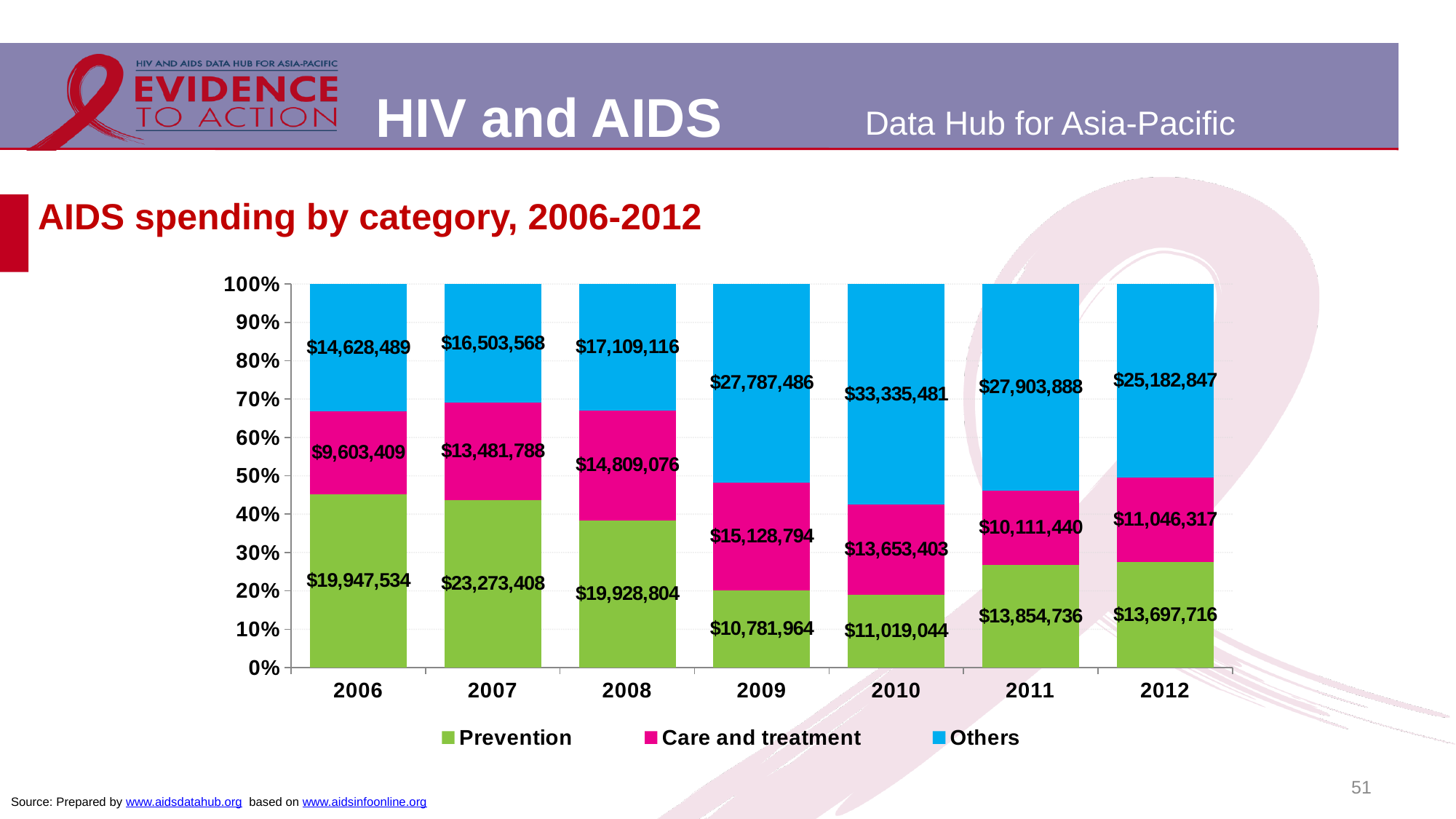
What was the Others spending in 2010? $33,335,481 Is the Prevention share of the 2006 bar greater or less than 40%? greater Which was larger in 2008: Prevention spending or Care and treatment spending? Prevention What was the Care and treatment spending in 2009? $15,128,794 What kind of chart is shown on the slide? Stacked bar chart What was the Prevention spending in 2007? $23,273,408 What is the difference between Others spending in 2010 and in 2009? $5,547,995 In which year was Others spending highest? 2010 How many series does the legend list? 3 What is the total AIDS spending across the three categories in 2006? $44,179,432 How many years are shown on the x axis? 7 In which year was Prevention spending lowest? 2009